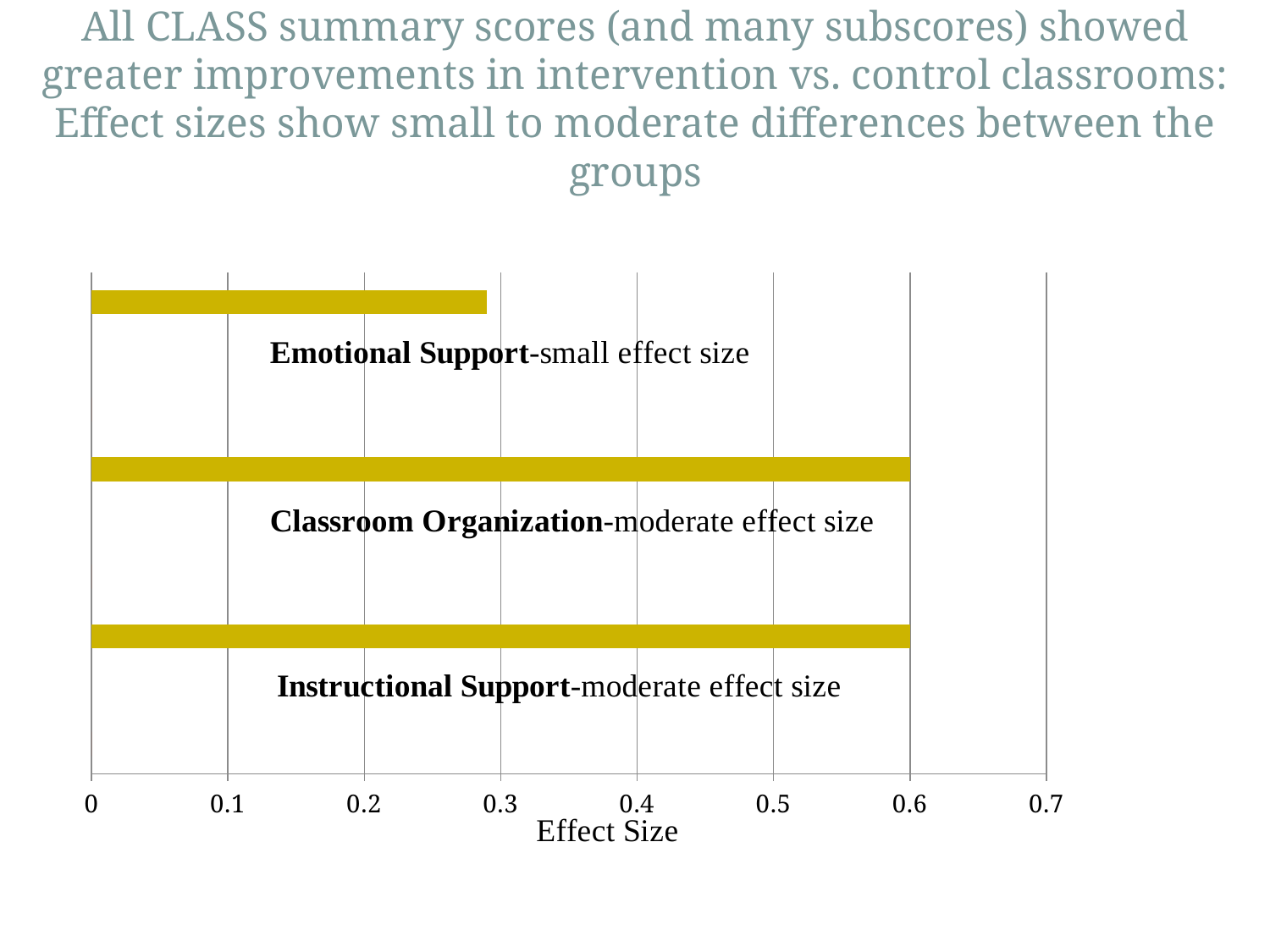
Is the effect size for Emotional Support greater or less than 0.2? greater Which category has the lowest effect size? Emotional Support What is the difference between the effect sizes for Classroom Organization and Instructional Support? 0 Is the effect size for Emotional Support greater or less than 0.4? less What is the highest value shown on the horizontal axis? 0.7 What is the title of the horizontal axis? Effect Size How many categories are plotted in the chart? 3 What is the effect size for Instructional Support? 0.6 What kind of chart is shown on the slide? bar chart Which has a larger effect size, Emotional Support or Classroom Organization? Classroom Organization Which has a larger effect size, Instructional Support or Emotional Support? Instructional Support What is the effect size for Classroom Organization? 0.6